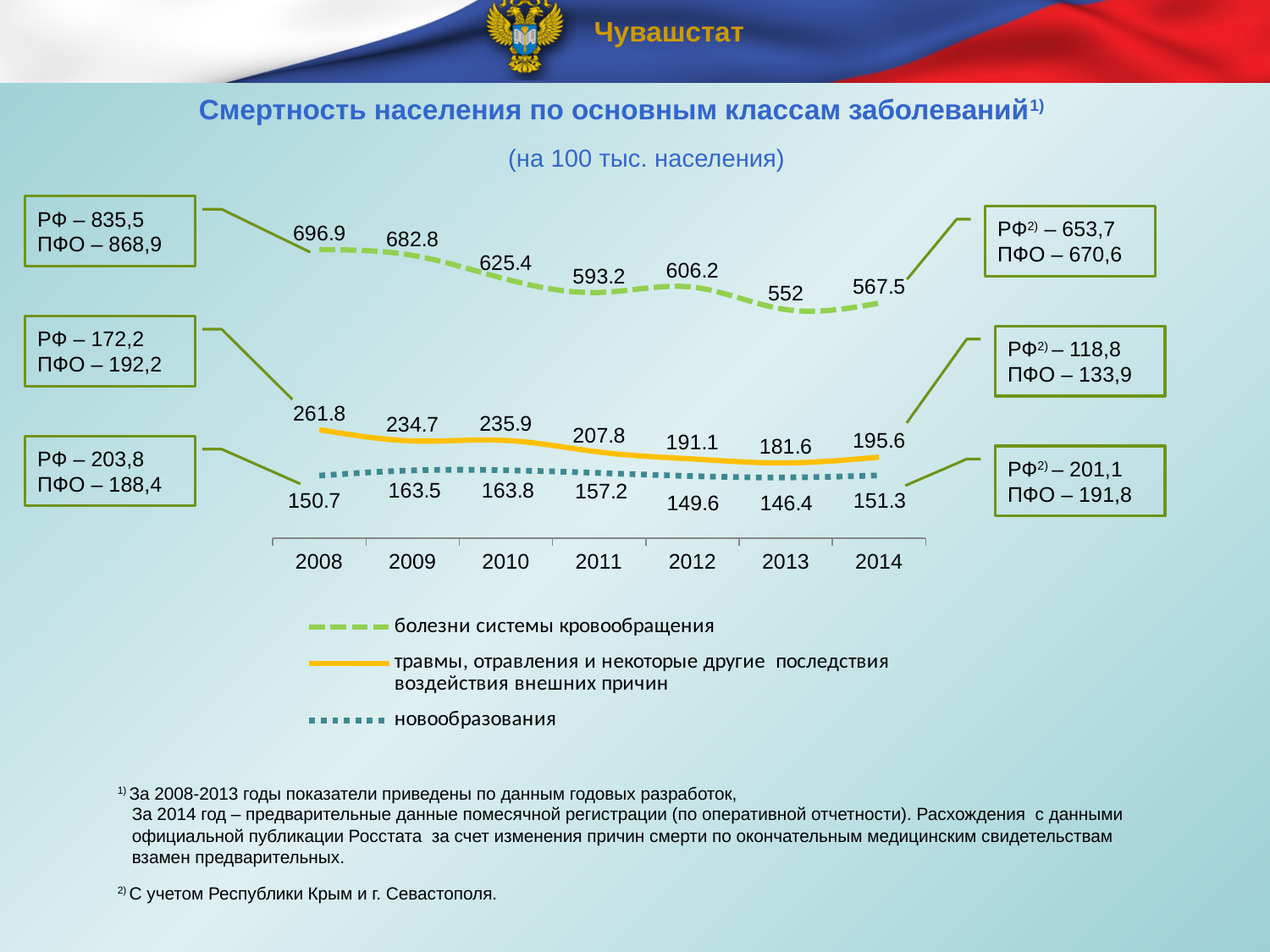
In which year is the value for болезни системы кровообращения lowest? 2013 How many years are shown on the x axis? 7 In which year is the value for новообразования highest? 2010 Which is larger: the 2012 value for болезни системы кровообращения or the 2011 value for the same series? 2012 What is the unit stated under the chart title? на 100 тыс. населения What is the value for новообразования in 2014? 151.3 What is the value for травмы, отравления и некоторые другие последствия воздействия внешних причин in 2011? 207.8 What is the value for болезни системы кровообращения in 2008? 696.9 How many series does the legend list? 3 Does the value for травмы, отравления и некоторые другие последствия воздействия внешних причин rise or fall from 2008 to 2013? fall What type of chart is shown on the slide? line chart What is the difference between the 2008 and 2014 values for травмы, отравления и некоторые другие последствия воздействия внешних причин? 66.2